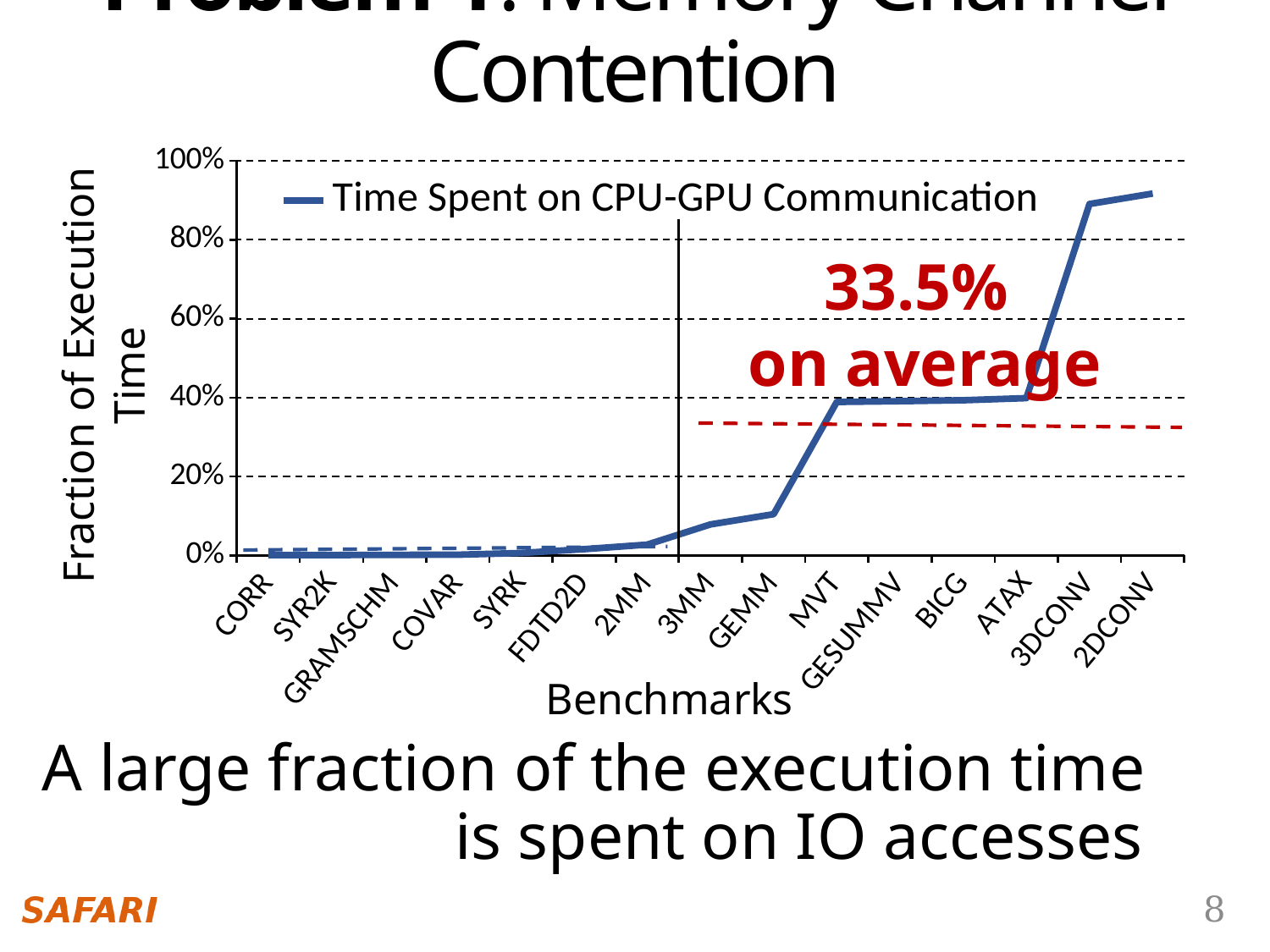
Which benchmark has the highest fraction of execution time spent on CPU-GPU communication? 2DCONV How many series does the legend list? 1 What kind of chart is shown on the slide? line chart Do the values rise or fall moving from left to right along the x axis? rise What is the name of the series shown in the legend? Time Spent on CPU-GPU Communication Which has a larger value, MVT or GEMM? MVT What average value is annotated on the chart? 33.5% Is the value for CORR greater or less than 20%? less How many benchmarks are plotted along the x axis? 15 Is the value for 2DCONV greater or less than 80%? greater What is the x-axis title of the chart? Benchmarks Is the value for MVT greater or less than 20%? greater